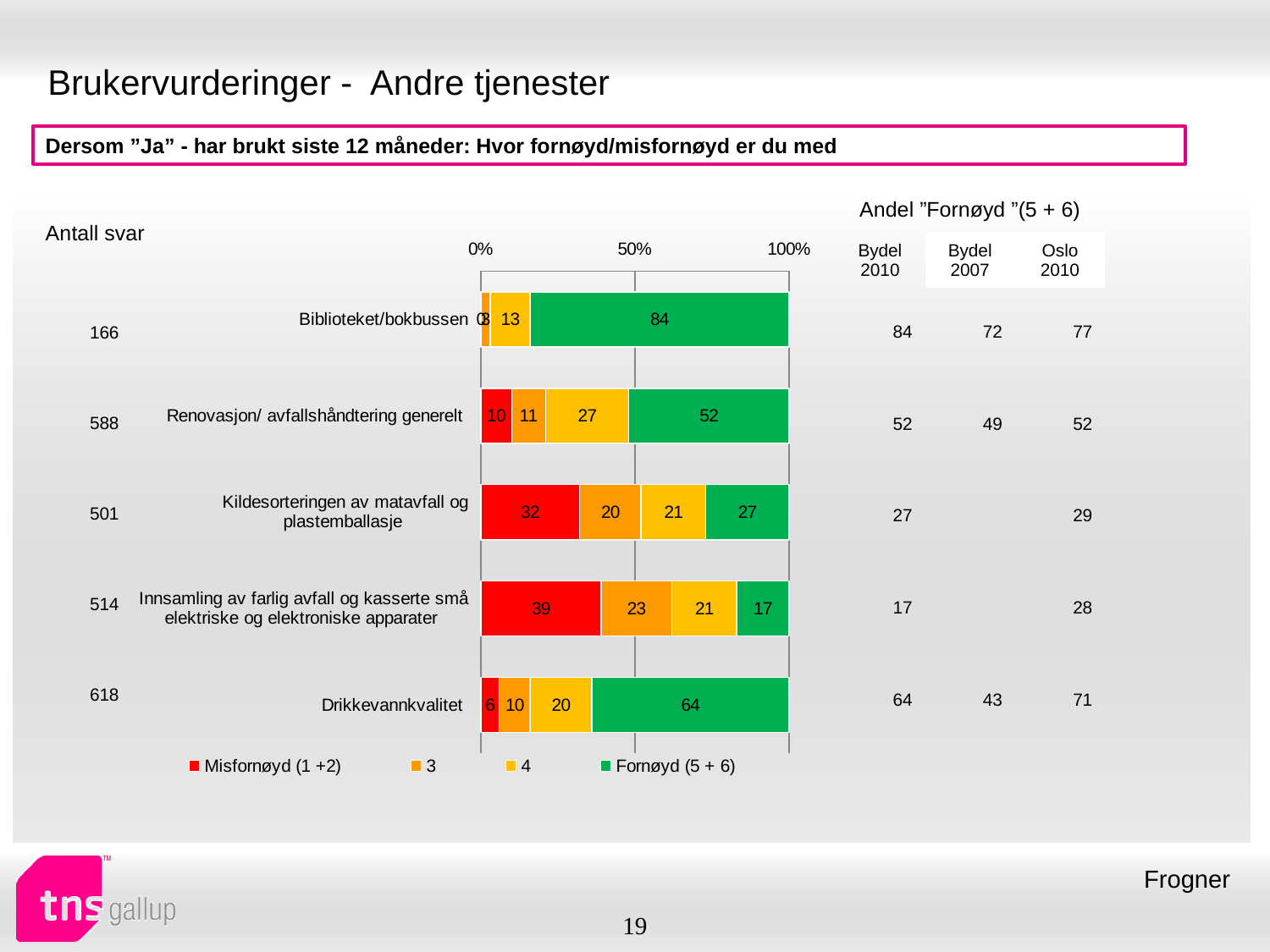
What is the value of the Misfornøyd (1 +2) segment for Innsamling av farlig avfall og kasserte små elektriske og elektroniske apparater? 39 How many series does the legend list? 4 What kind of chart is shown on the slide? Stacked bar chart Which category has the highest Fornøyd (5 + 6) value? Biblioteket/bokbussen Which has the larger Misfornøyd (1 +2) value: Kildesorteringen av matavfall og plastemballasje or Innsamling av farlig avfall og kasserte små elektriske og elektroniske apparater? Innsamling av farlig avfall og kasserte små elektriske og elektroniske apparater What is the value of the '3' segment for Drikkevannkvalitet? 10 What is the value of the '4' segment for Renovasjon/ avfallshåndtering generelt? 27 Which category has the lowest Fornøyd (5 + 6) value? Innsamling av farlig avfall og kasserte små elektriske og elektroniske apparater What is the total of the stacked bar for Kildesorteringen av matavfall og plastemballasje? 100 How many categories are shown in the chart? 5 What is the value of the Fornøyd (5 + 6) segment for Drikkevannkvalitet? 64 What is the difference between the Fornøyd (5 + 6) values for Drikkevannkvalitet and Renovasjon/ avfallshåndtering generelt? 12